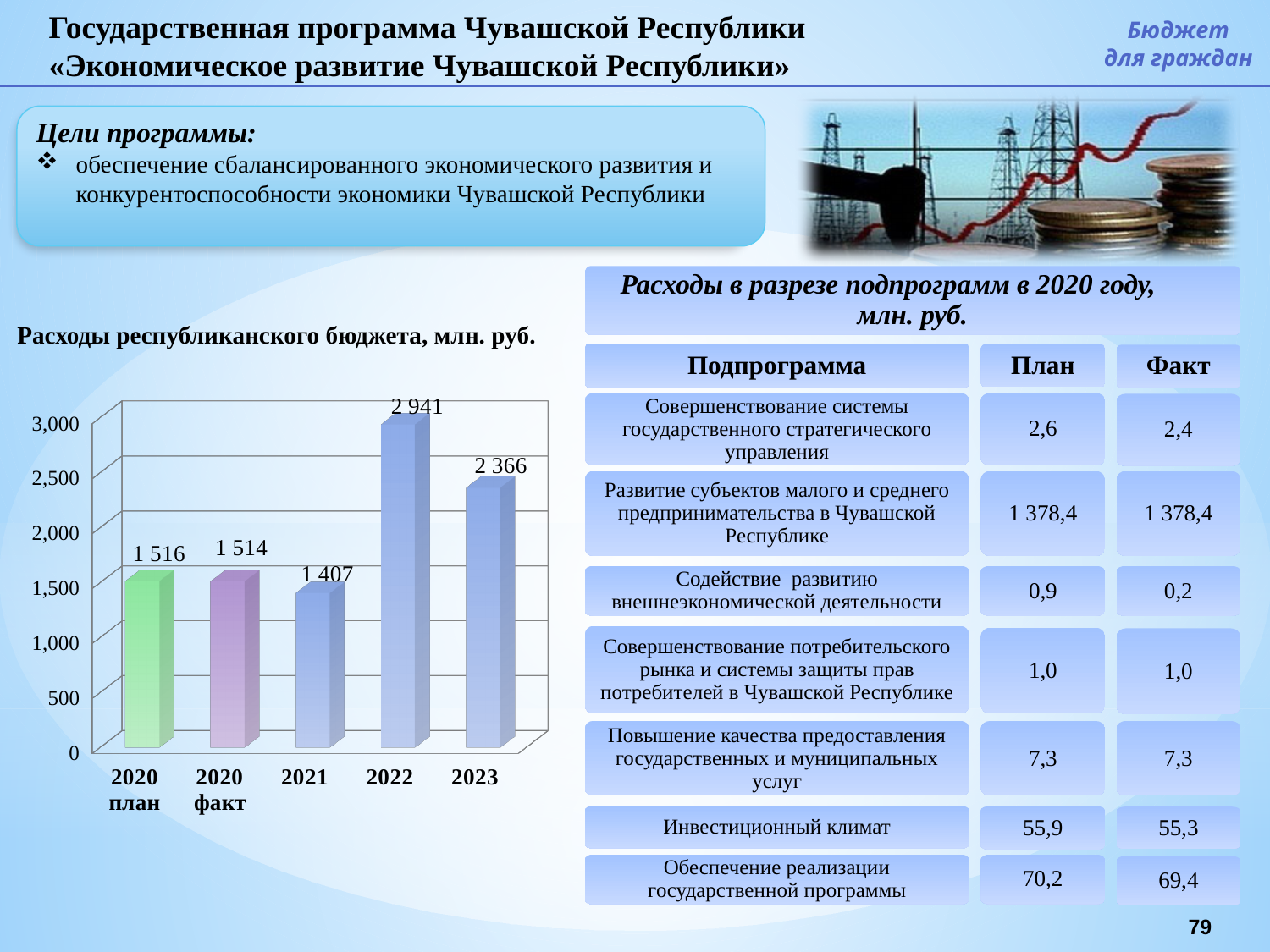
How many bars are shown in the chart 'Расходы республиканского бюджета, млн. руб.'? 5 What is the difference between the values for '2020 план' and '2020 факт' in the chart 'Расходы республиканского бюджета, млн. руб.'? 2 What is the value for 2023 in the chart 'Расходы республиканского бюджета, млн. руб.'? 2 366 What is the value for '2020 план' in the chart 'Расходы республиканского бюджета, млн. руб.'? 1 516 What is the value for 2021 in the chart 'Расходы республиканского бюджета, млн. руб.'? 1 407 What is the value for 2022 in the chart 'Расходы республиканского бюджета, млн. руб.'? 2 941 What type of chart is 'Расходы республиканского бюджета, млн. руб.'? bar chart Which category has the lowest value in the chart 'Расходы республиканского бюджета, млн. руб.'? 2021 Which is larger in the chart 'Расходы республиканского бюджета, млн. руб.': the value for 2021 or the value for 2023? 2023 Is the value for 2022 in the chart 'Расходы республиканского бюджета, млн. руб.' greater or less than 2,500? greater Which category has the highest value in the chart 'Расходы республиканского бюджета, млн. руб.'? 2022 What is the difference between the values for 2022 and 2023 in the chart 'Расходы республиканского бюджета, млн. руб.'? 575